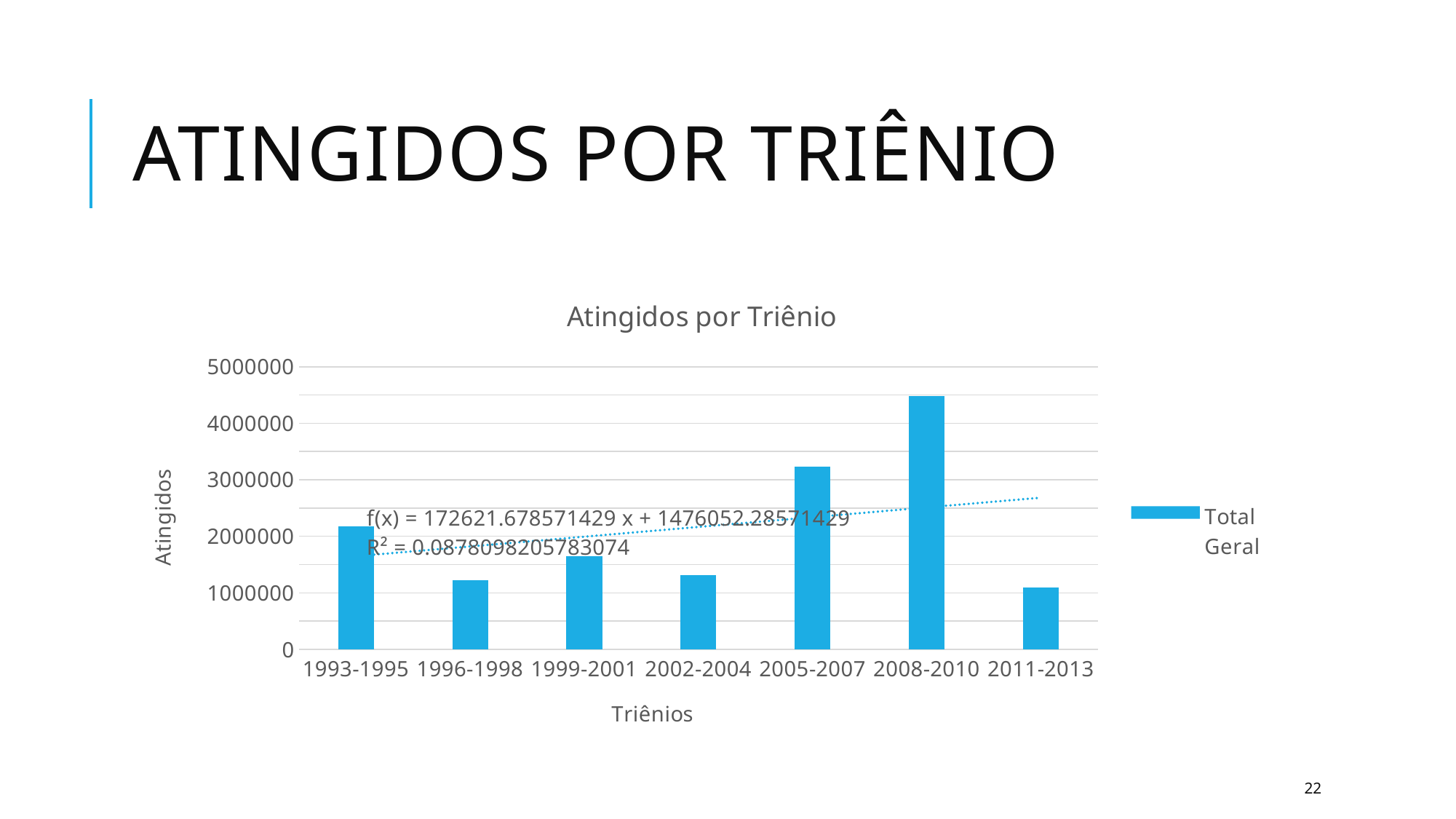
Which triennium has the highest value? 2008-2010 How many series does the legend list? 1 What series name is shown in the legend? Total Geral Is the value for 2008-2010 greater or less than 4000000? greater Is the value for 2005-2007 greater or less than 3000000? greater Is the value for 1993-1995 greater or less than 2000000? greater Which is larger, the value for 2005-2007 or the value for 1993-1995? 2005-2007 What is the title of the chart? Atingidos por Triênio What kind of chart is shown on the slide? bar chart How many triennia (categories) are shown on the x axis? 7